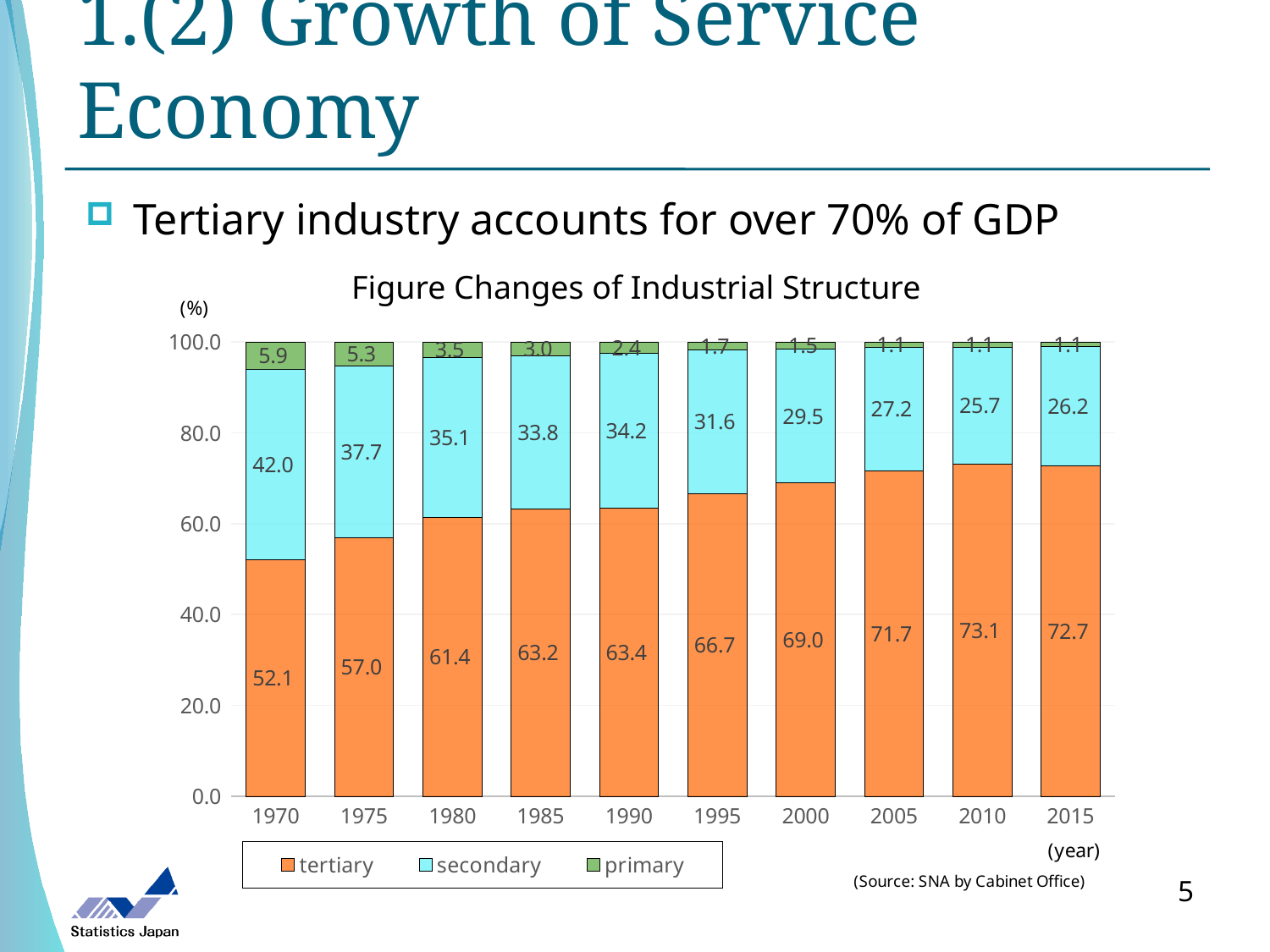
What is the secondary share in 2000? 29.5 In which year is the tertiary share lowest? 1970 What is the tertiary share in 1970? 52.1 How many years are shown on the x axis? 10 How many series does the legend list? 3 What is the title of the chart? Figure Changes of Industrial Structure In which year is the tertiary share highest? 2010 What kind of chart is shown? Stacked bar chart What is the primary share in 1990? 2.4 Does the secondary share generally rise or fall from 1970 to 2015? Fall By how much did the tertiary share increase from 1970 to 2015? 20.6 Which year has the larger secondary share, 1985 or 1990? 1990